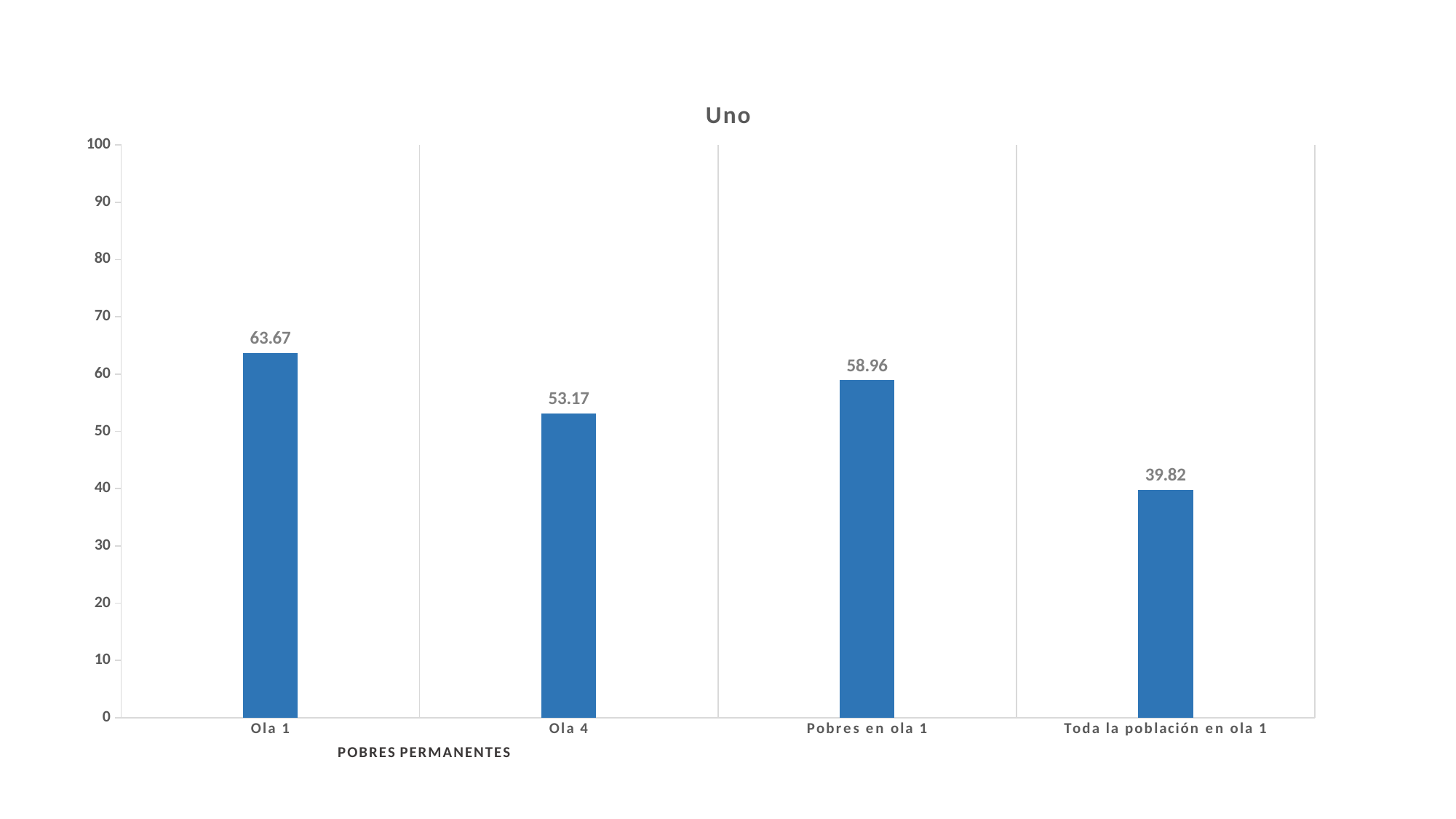
What is the title of the chart? Uno Which category has the highest value? Ola 1 What is the difference between the values for Ola 1 and Ola 4? 10.5 What is the value for Ola 4? 53.17 How many categories are shown on the x axis? 4 What is the value for Toda la población en ola 1? 39.82 What is the value for Ola 1? 63.67 Which category has the lowest value? Toda la población en ola 1 What kind of chart is shown on the slide? bar chart Which is larger, the value for Pobres en ola 1 or the value for Toda la población en ola 1? Pobres en ola 1 Is the value for Ola 4 greater or less than 50? greater What is the value for Pobres en ola 1? 58.96